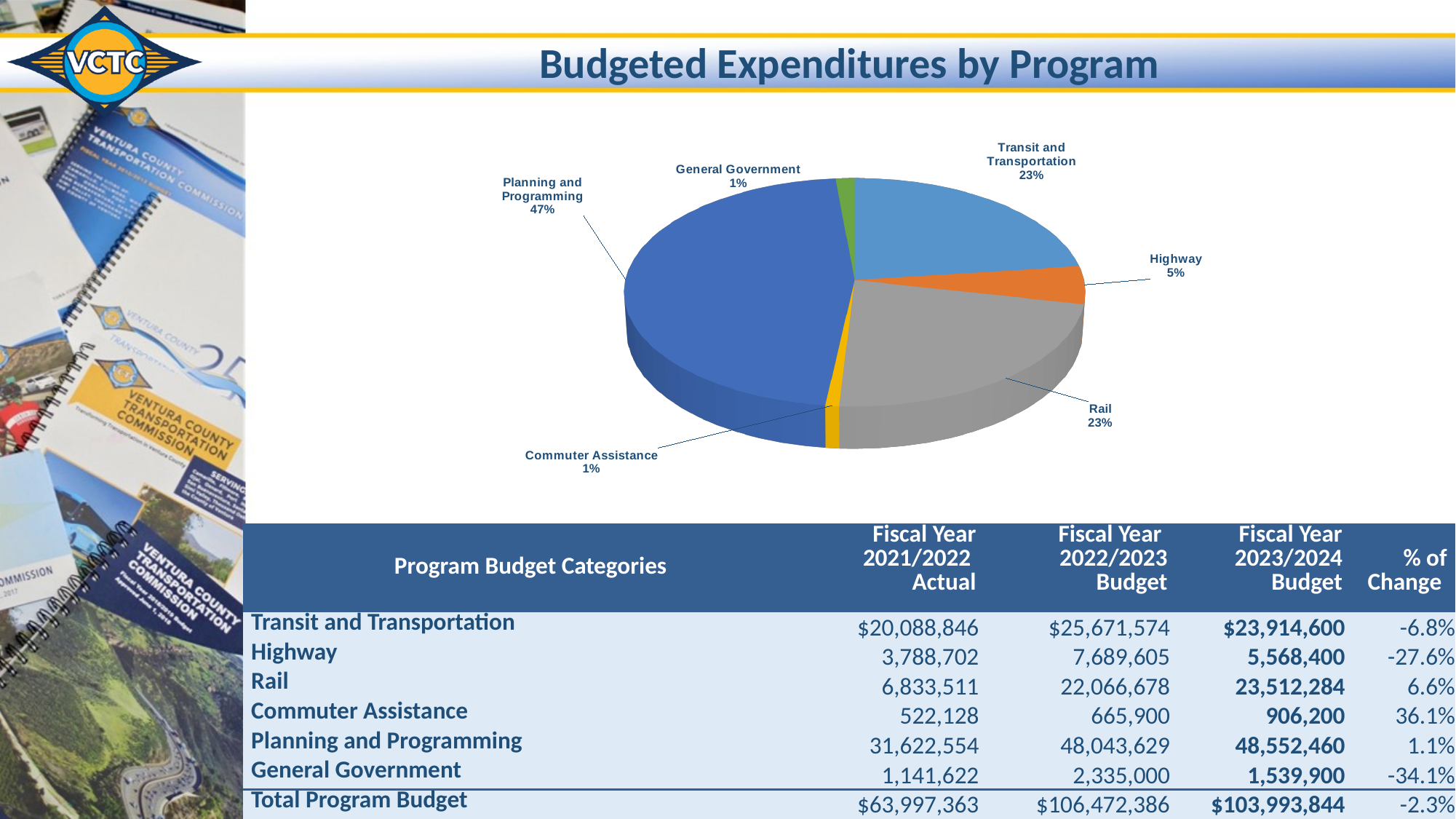
What is the title of the slide containing the pie chart? Budgeted Expenditures by Program By how many percentage points does Planning and Programming exceed Transit and Transportation in the pie chart? 24 What percentage is shown for Commuter Assistance in the pie chart? 1% What percentage is shown for Rail in the pie chart? 23% How many slices does the pie chart have? 6 What percentage is shown for General Government in the pie chart? 1% What share of the pie does Planning and Programming represent? 47% What percentage is shown for Transit and Transportation in the pie chart? 23% Which program has the largest slice of the pie chart? Planning and Programming Which is larger in the pie chart, Highway or General Government? Highway What kind of chart is shown on the slide? pie chart What percentage is shown for Highway in the pie chart? 5%